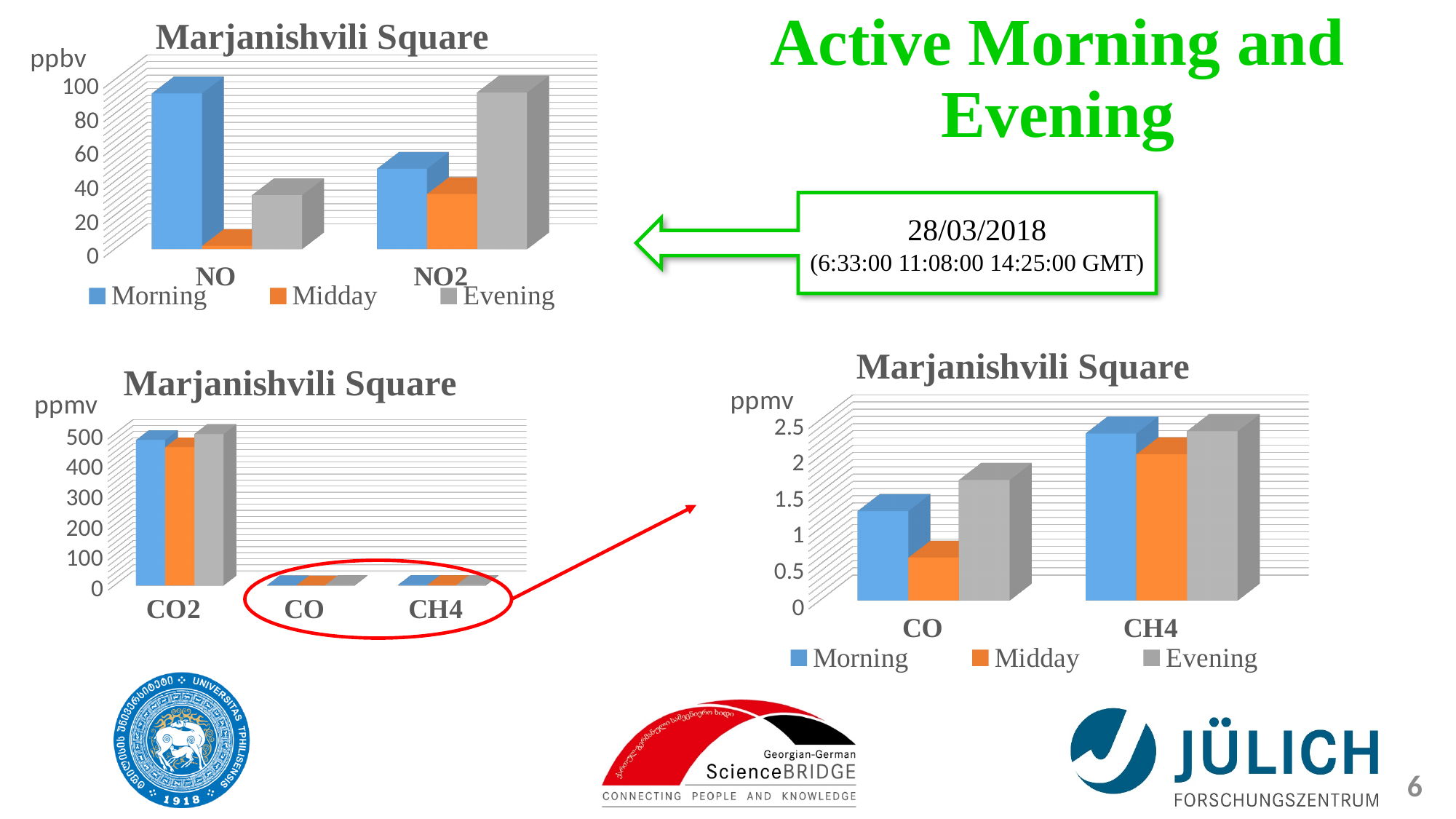
In the bottom-left chart (ppmv), is the Morning value for CO2 greater or less than 400? greater In the bottom-right chart (ppmv), which time of day has the lowest value for CO? Midday What type of chart is the bottom-right chart? bar chart In the top-left chart (ppbv), is the Midday value for NO greater or less than 20? less In the bottom-right chart (ppmv), is the Midday value for CO greater or less than 1? less In the top-left chart (ppbv), which time of day has the lowest value for NO? Midday In the top-left chart (ppbv), which is larger for NO2: the Morning value or the Evening value? Evening How many series does the legend of the top-left chart list? 3 How many categories are shown on the x axis of the bottom-left chart (ppmv)? 3